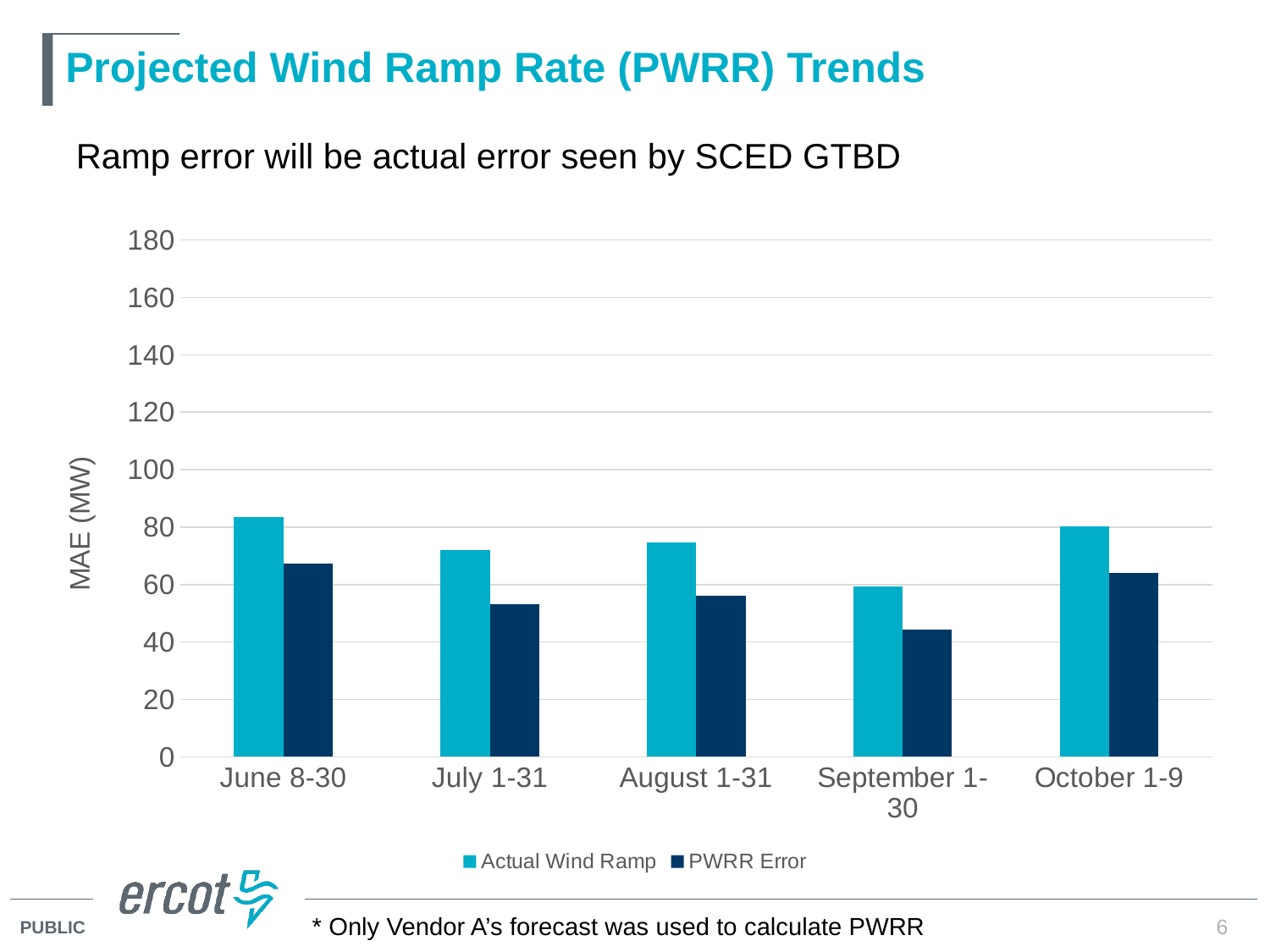
Is the Actual Wind Ramp value for October 1-9 greater or less than 60? greater What are the two series named in the chart's legend? Actual Wind Ramp and PWRR Error What kind of chart is shown on the slide? bar chart Which period has the lowest Actual Wind Ramp value? September 1-30 For September 1-30, which is larger: Actual Wind Ramp or PWRR Error? Actual Wind Ramp Is the PWRR Error value for September 1-30 greater or less than 60? less For June 8-30, which is larger: Actual Wind Ramp or PWRR Error? Actual Wind Ramp Is the Actual Wind Ramp value for June 8-30 greater or less than 100? less What is the label on the y axis of the chart? MAE (MW) How many time periods are shown on the x axis of the chart? 5 Which period has the lowest PWRR Error value? September 1-30 How many series does the chart's legend list? 2